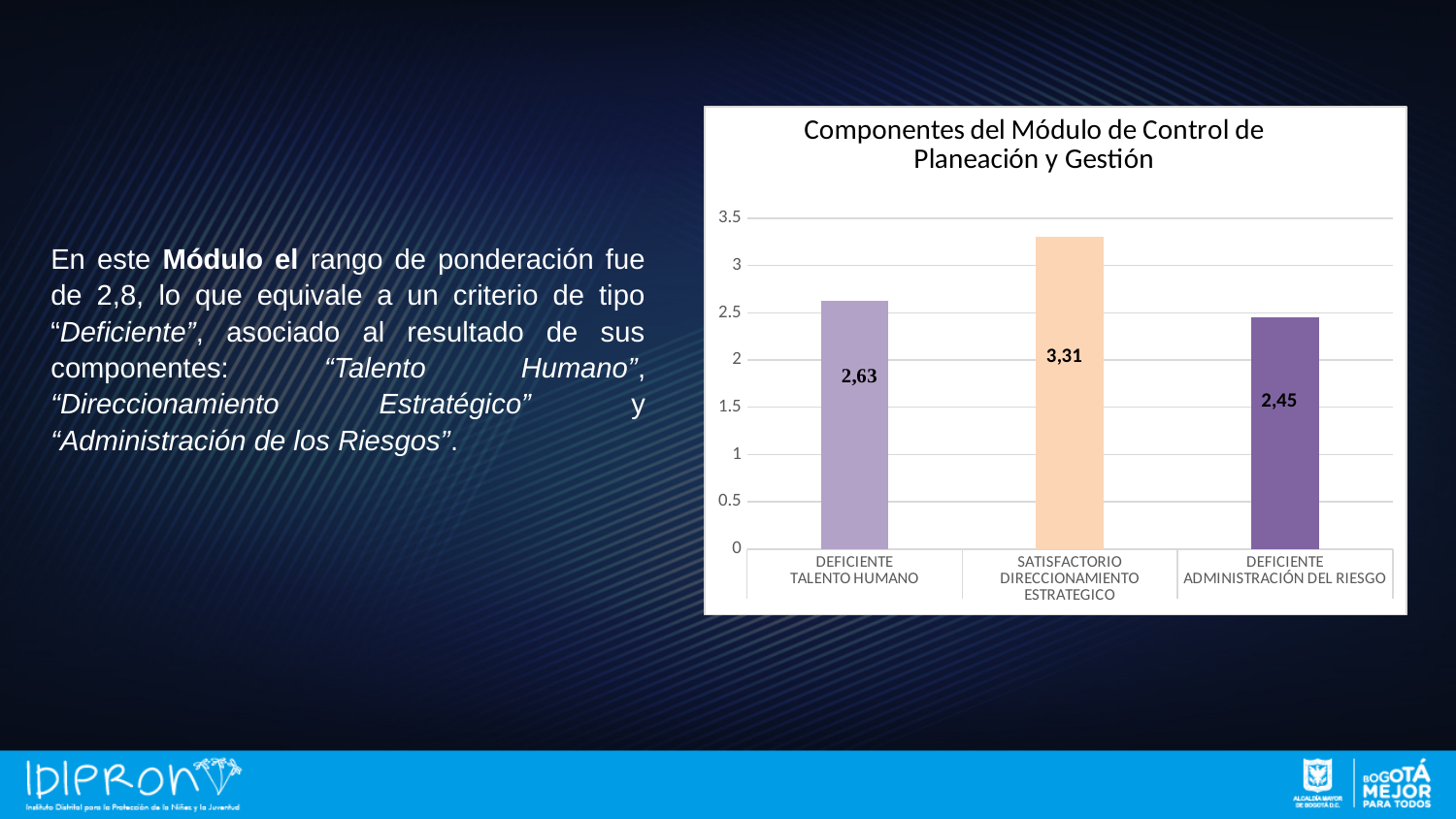
What is the difference between the values for Talento Humano and Administración del Riesgo? 0,18 Which component has the highest value? Direccionamiento Estrategico What is the title of the chart? Componentes del Módulo de Control de Planeación y Gestión How many components are plotted in the chart? 3 Which is larger, the value for Talento Humano or the value for Administración del Riesgo? Talento Humano What is the value for Administración del Riesgo? 2,45 What kind of chart is shown on the slide? Bar chart What is the value for Talento Humano? 2,63 What is the value for Direccionamiento Estrategico? 3,31 Is the value for Direccionamiento Estrategico greater or less than 3? greater Which component has the lowest value? Administración del Riesgo What is the difference between the values for Direccionamiento Estrategico and Talento Humano? 0,68